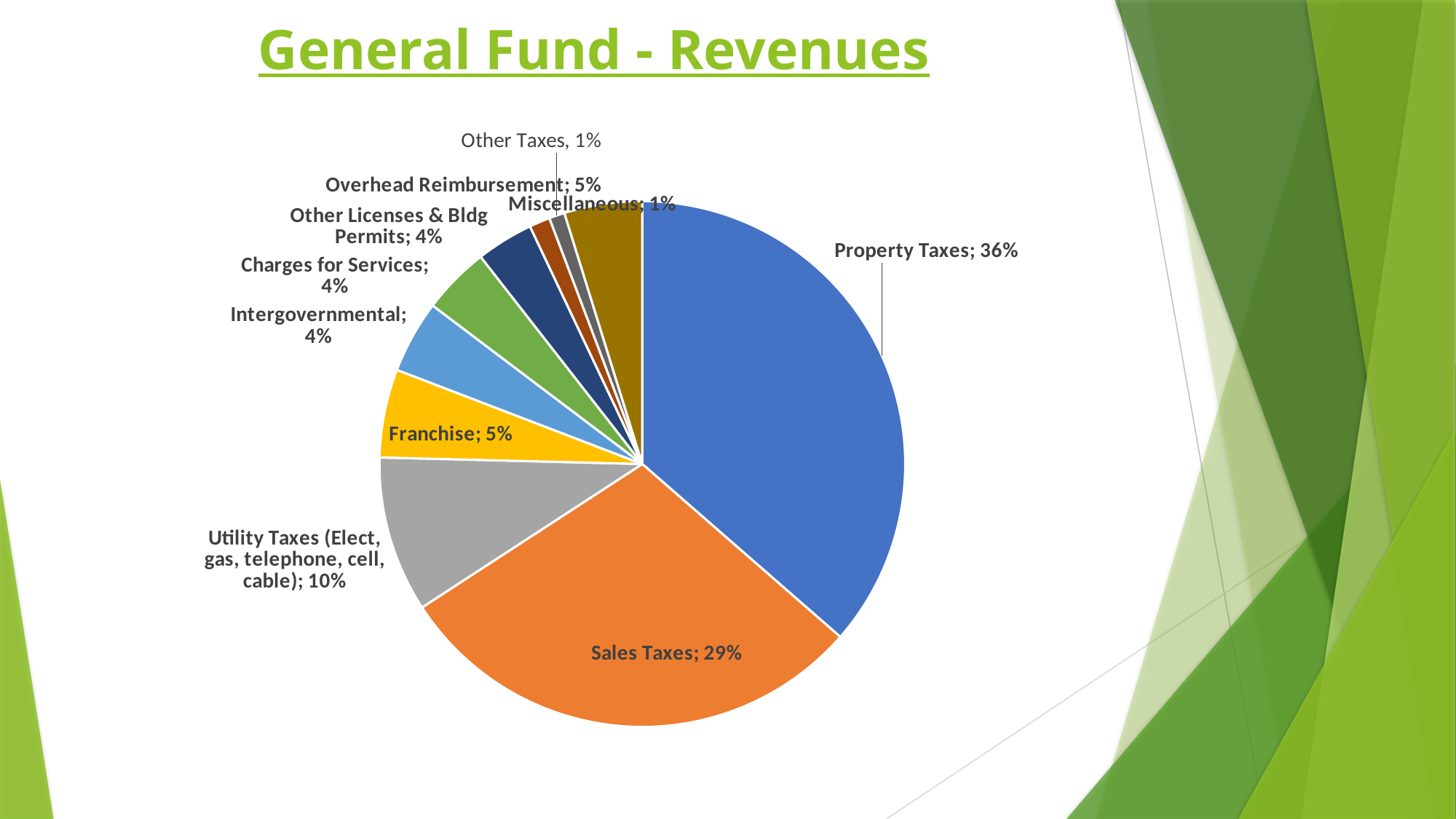
What is the difference in percentage points between Property Taxes and Sales Taxes? 7 Which is larger, the share for Franchise or the share for Intergovernmental? Franchise What share of General Fund revenues comes from Property Taxes? 36% What colour is the Sales Taxes slice? Orange What percentage of the pie is Sales Taxes? 29% What is the title of the slide? General Fund - Revenues What share is shown for Utility Taxes (Elect, gas, telephone, cell, cable)? 10% What kind of chart is shown on the slide? Pie chart Which is larger, Utility Taxes or Overhead Reimbursement? Utility Taxes Which revenue category has the largest share of the pie? Property Taxes How many revenue categories are shown in the pie chart? 10 What percentage is labelled for Overhead Reimbursement? 5%